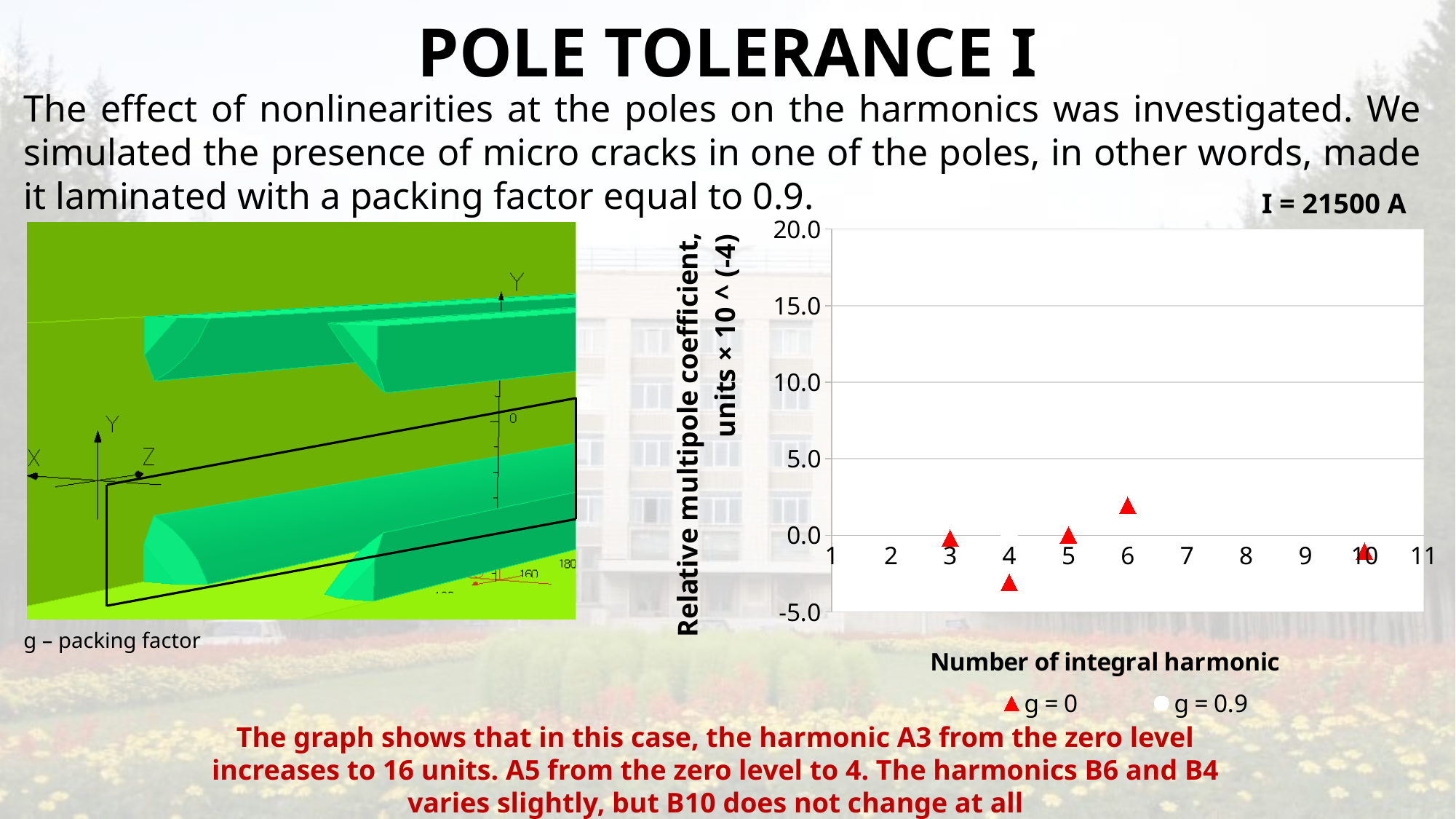
What are the two series named in the chart legend? g = 0 and g = 0.9 Is the g = 0 value at harmonic 6 greater or less than 0.0? greater Is the g = 0 value at harmonic 4 greater or less than 0.0? less What kind of chart is shown on the slide? scatter chart At which harmonic number does the g = 0 series reach its highest value? 6 Is the g = 0 value at harmonic 4 greater or less than -5.0? greater At which harmonic number does the g = 0 series reach its lowest value? 4 What is the title of the chart's x axis? Number of integral harmonic How many series does the chart legend list? 2 For the g = 0 series, which is larger: the value at harmonic 6 or the value at harmonic 4? harmonic 6 How many red triangle (g = 0) points are plotted on the chart? 5